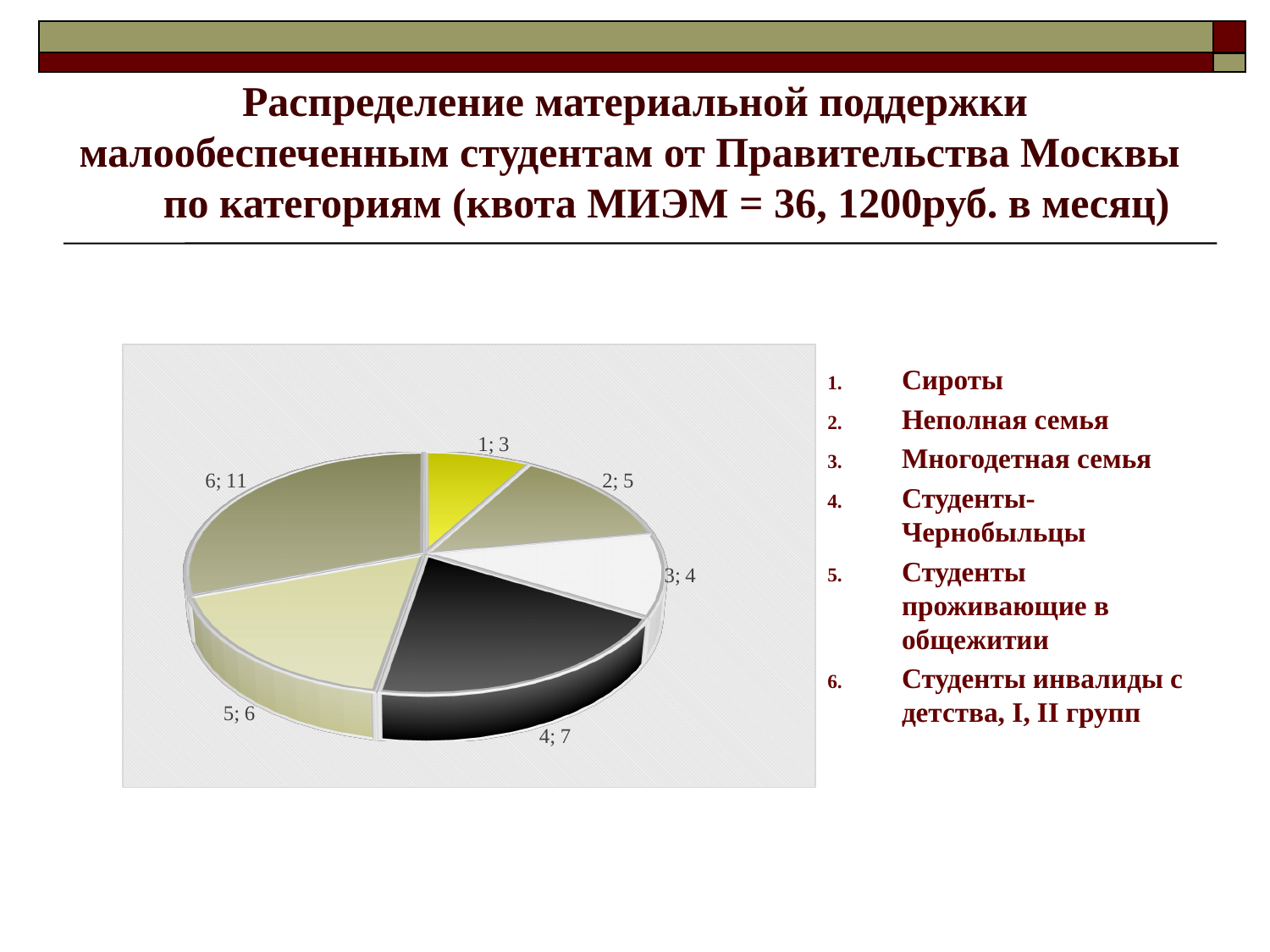
How many slices does the pie chart have? 6 What kind of chart is shown on the slide? pie chart Which is larger, the value for category 2 (Неполная семья) or category 3 (Многодетная семья)? category 2 (Неполная семья) What is the value for category 6 (Студенты инвалиды с детства, I, II групп)? 11 Which category has the smallest slice in the pie chart? 1 (Сироты) What is the value for category 5 (Студенты проживающие в общежитии)? 6 What is the total of all the values shown in the pie chart? 36 Which category has the largest slice in the pie chart? 6 (Студенты инвалиды с детства, I, II групп) What is the value for category 1 (Сироты) in the pie chart? 3 What is the difference between the values for category 6 and category 1? 8 What colour is the slice for category 4 in the pie chart? black What is the value for category 4 (Студенты-Чернобыльцы)? 7